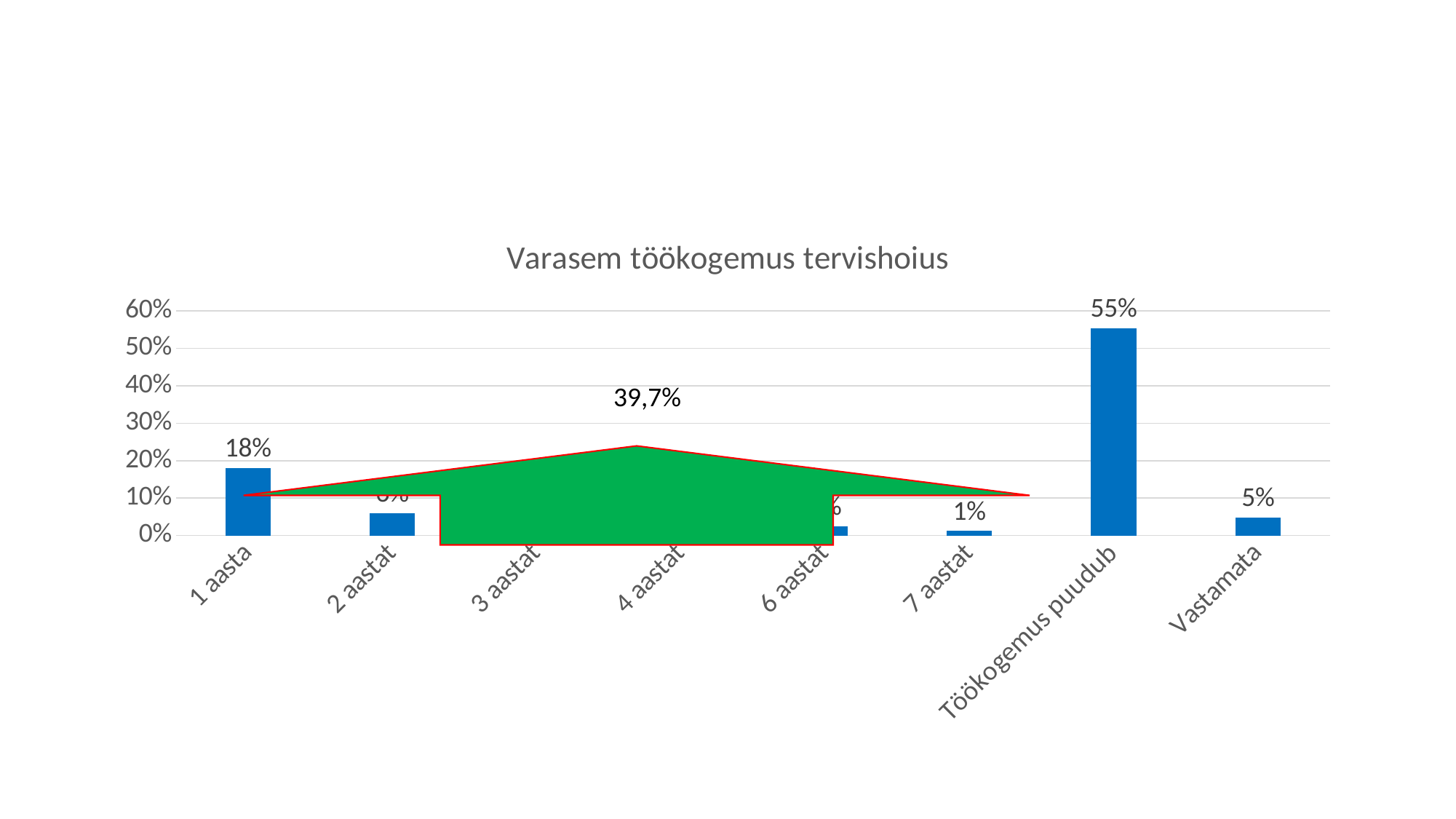
What is the difference between the values for "Töökogemus puudub" and "1 aasta"? 37 percentage points What is the value for "7 aastat"? 1% Which category has the highest value? Töökogemus puudub What is the value for "1 aasta"? 18% How many categories are shown on the x axis? 8 Is the value for "Töökogemus puudub" greater or less than 50%? greater What is the value for "Vastamata"? 5% What kind of chart is shown on the slide? bar chart What is the value for "Töökogemus puudub"? 55% What is the title of the chart? Varasem töökogemus tervishoius Which is larger, the value for "1 aasta" or the value for "Vastamata"? 1 aasta Is the value for "2 aastat" greater or less than 10%? less